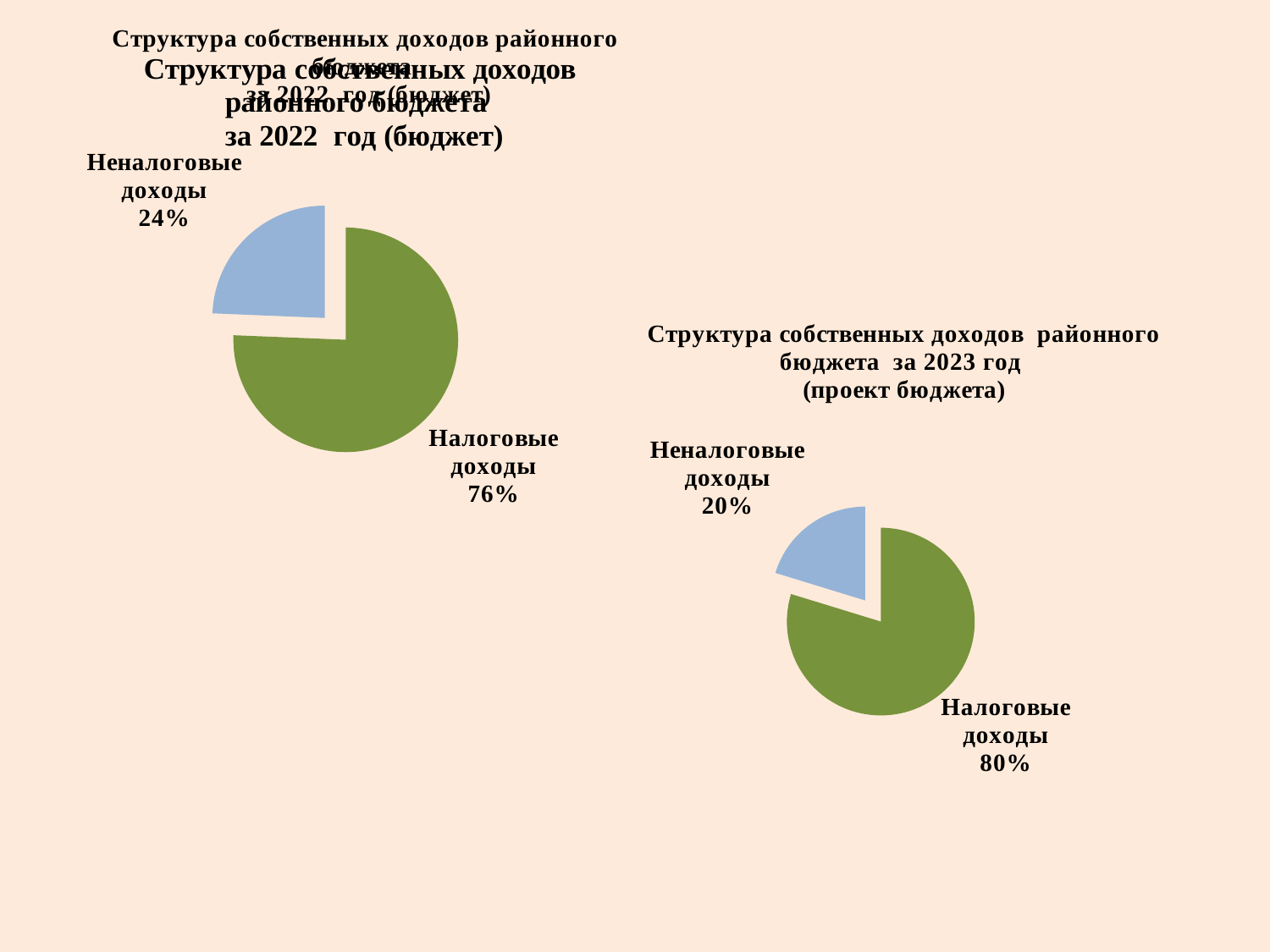
In the left chart (2022 budget), what share do Неналоговые доходы have? 24% In the right chart (2023 project budget), what share do Неналоговые доходы have? 20% In the right chart (2023 project budget), what share do Налоговые доходы have? 80% Which chart shows a larger share for Неналоговые доходы, the left (2022) or the right (2023)? the left (2022) How many slices does the right chart (2023 project budget) have? 2 In the right chart (2023 project budget), which category has the smallest slice? Неналоговые доходы In the left chart (2022 budget), what is the difference in percentage points between Налоговые доходы and Неналоговые доходы? 52 In the right chart (2023 project budget), what is the difference in percentage points between Налоговые доходы and Неналоговые доходы? 60 In the left chart (2022 budget), which category has the largest slice? Налоговые доходы In the right chart (2023 project budget), what colour is the Налоговые доходы slice? green In the left chart (2022 budget), what share do Налоговые доходы have? 76% What type of chart is used on this slide? pie chart